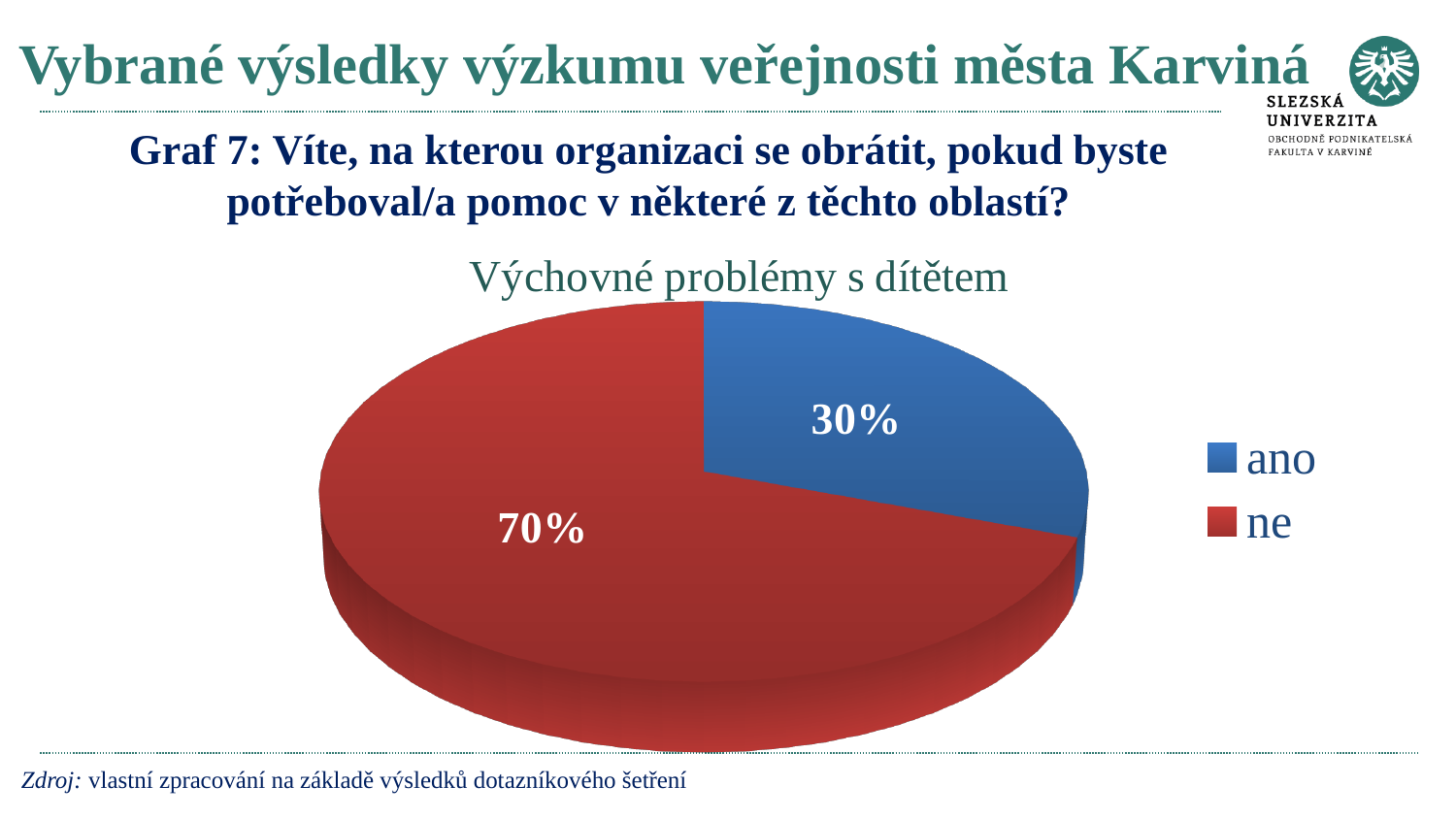
What is the difference in percentage points between the "ne" and "ano" slices? 40 percentage points How many entries does the legend list? 2 Which category has the largest slice of the pie? ne What is the title of the pie chart? Výchovné problémy s dítětem Which is larger, the "ano" slice or the "ne" slice? ne What kind of chart is shown on the slide? pie chart What share of the pie does the "ne" slice represent? 70% Which category has the smallest slice of the pie? ano How many categories does the pie chart show? 2 What colour is the "ne" slice in the pie chart? red What share of the pie does the "ano" slice represent? 30%